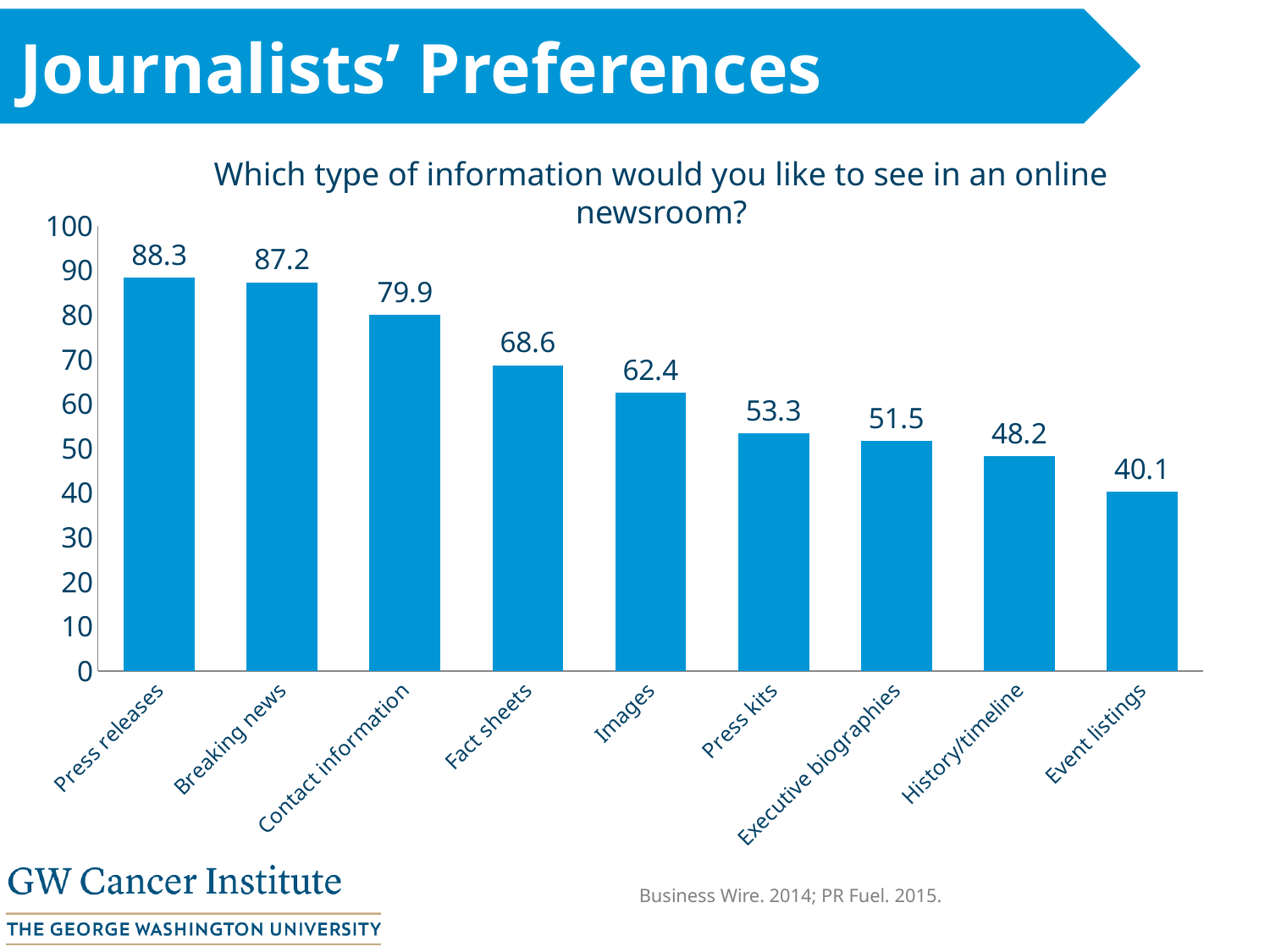
Do the values rise or fall from left to right along the x axis? Fall Which category has the highest value? Press releases How many categories are shown on the x axis? 9 Which is larger, the value for Press kits or the value for History/timeline? Press kits What kind of chart is shown on the slide? Bar chart What is the value for Executive biographies? 51.5 Which category has the lowest value? Event listings What is the value for Press releases? 88.3 What is the difference between the values for Press releases and Event listings? 48.2 What is the value for Fact sheets? 68.6 Is the value for Images greater or less than 60? greater What is the difference between the values for Contact information and Images? 17.5